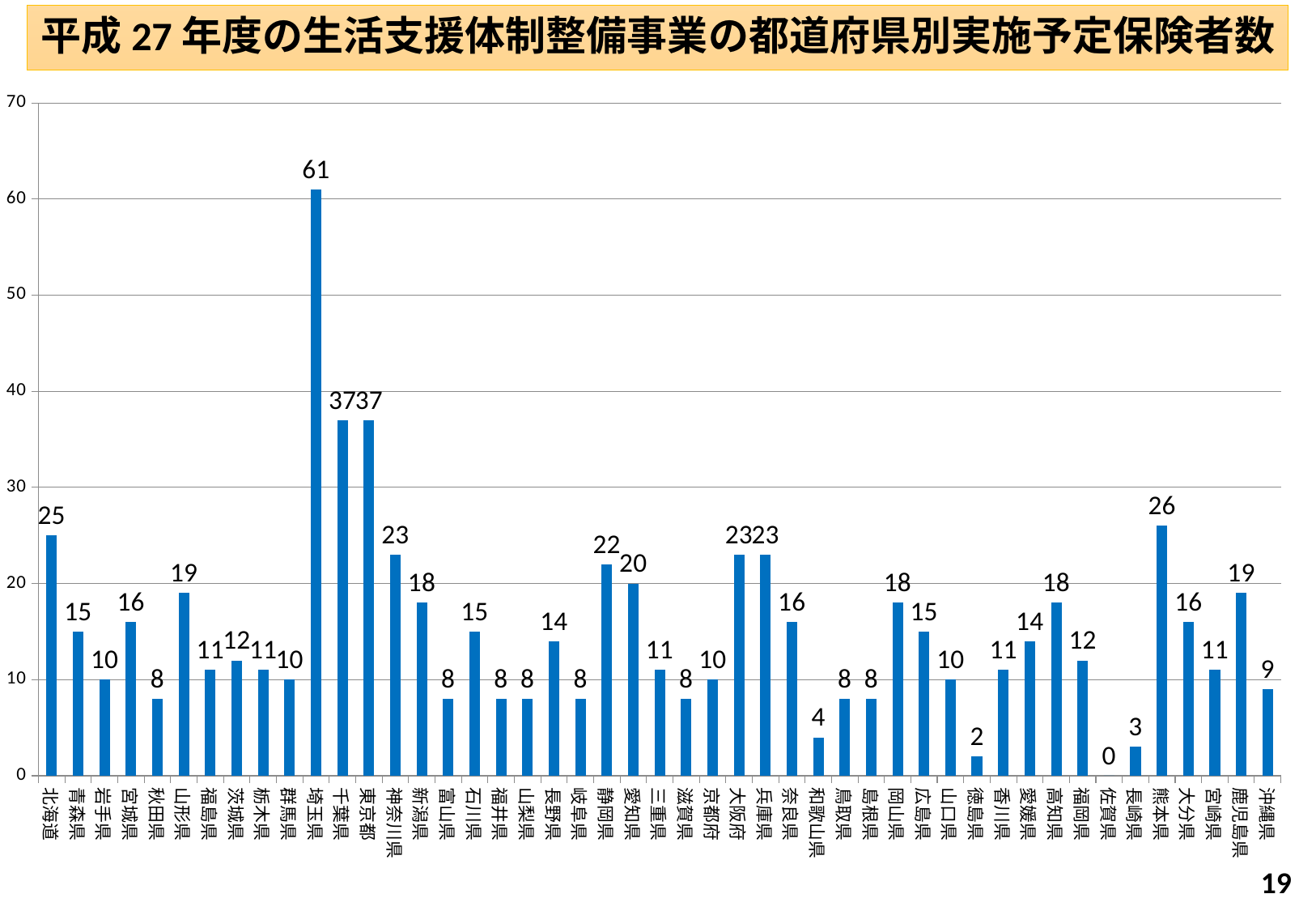
What is the title of the chart? 平成27年度の生活支援体制整備事業の都道府県別実施予定保険者数 Is the value for 東京都 greater or less than 30? greater What is the value for 徳島県? 2 What is the difference between the values for 埼玉県 and 千葉県? 24 Which is larger, the value for 北海道 or the value for 神奈川県? 北海道 Which prefecture has the highest value? 埼玉県 What kind of chart is shown on the slide? bar chart Which prefecture has the lowest value? 佐賀県 What is the value for 和歌山県? 4 What is the value for 熊本県? 26 What is the value for 埼玉県? 61 How many prefectures are shown on the x axis? 47